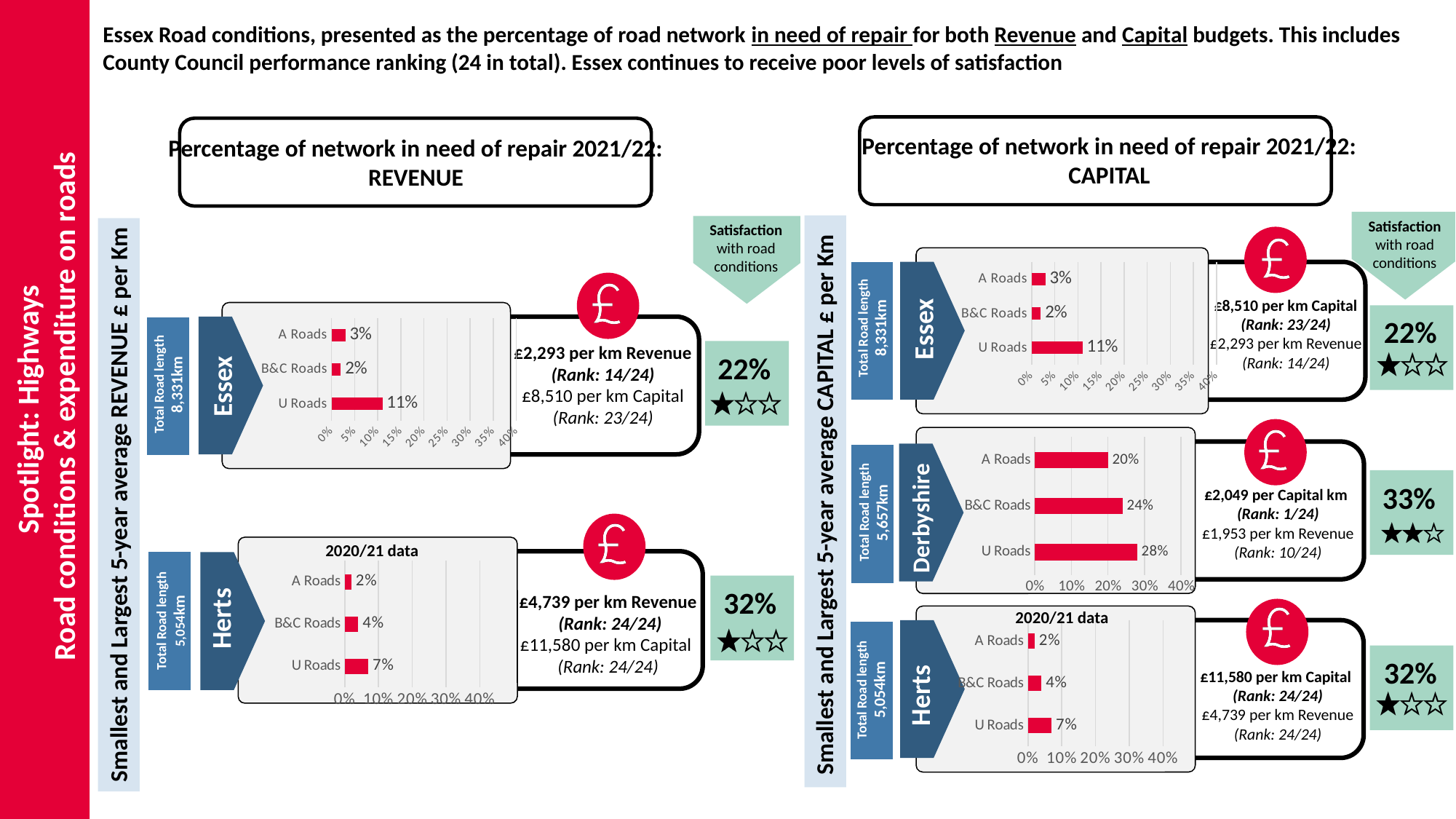
In the Herts chart under the REVENUE heading, which road category has the lowest percentage in need of repair? A Roads In the Herts chart under the CAPITAL heading, what is the difference between the U Roads and B&C Roads values? 3% In the Herts chart under the CAPITAL heading, what is the value for A Roads? 2% In the Essex chart under the CAPITAL heading, which is larger, the value for A Roads or the value for B&C Roads? A Roads In the Derbyshire chart under the CAPITAL heading, which road category has the highest percentage in need of repair? U Roads How many road categories are plotted in the Herts chart under the REVENUE heading? 3 In the Essex chart under the REVENUE heading, what is the value for B&C Roads? 2% In the Derbyshire chart under the CAPITAL heading, what is the difference between the U Roads and A Roads values? 8% What kind of chart is used to show the Essex percentage of network in need of repair under the REVENUE heading? Bar chart In the Derbyshire chart under the CAPITAL heading, what is the value for B&C Roads? 24% In the Essex chart under the REVENUE heading, what percentage of U Roads is in need of repair? 11% In the Derbyshire chart under the CAPITAL heading, is the value for U Roads greater or less than 20%? greater